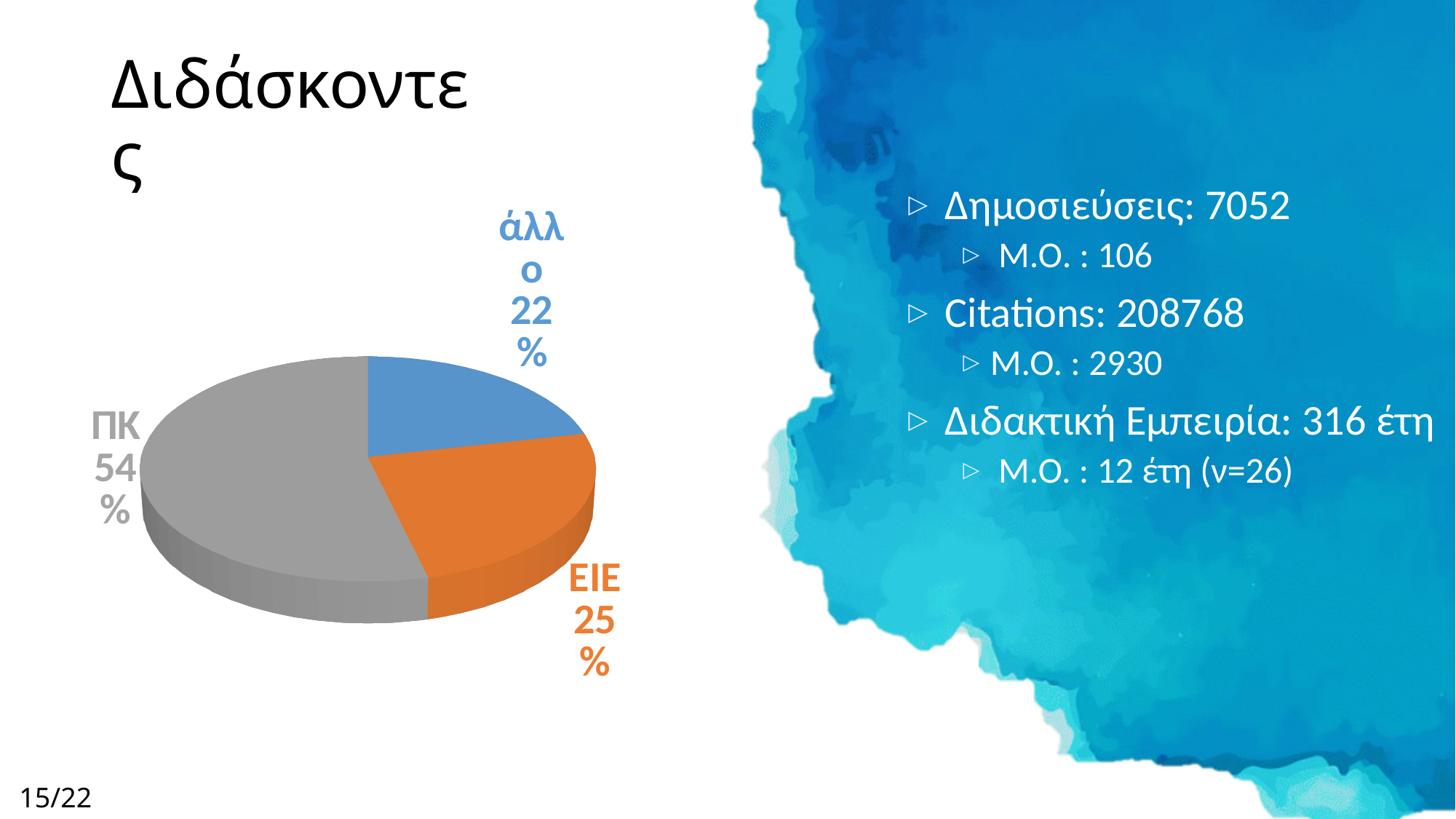
What is the difference in percentage points between the ΠΚ slice and the ΕΙΕ slice? 29 What colour is the ΠΚ slice in the pie chart? grey Which slice of the pie chart is the largest? ΠΚ What is the difference in percentage points between the ΕΙΕ slice and the άλλο slice? 3 What share of the pie does ΠΚ have? 54% What share of the pie does άλλο have? 22% How many slices does the pie chart have? 3 What share of the pie does ΕΙΕ have? 25% Which slice of the pie chart is the smallest? άλλο Is the share for ΠΚ greater or less than 50%? greater What kind of chart is shown on the slide? pie chart Which is larger in the pie chart, ΕΙΕ or άλλο? ΕΙΕ